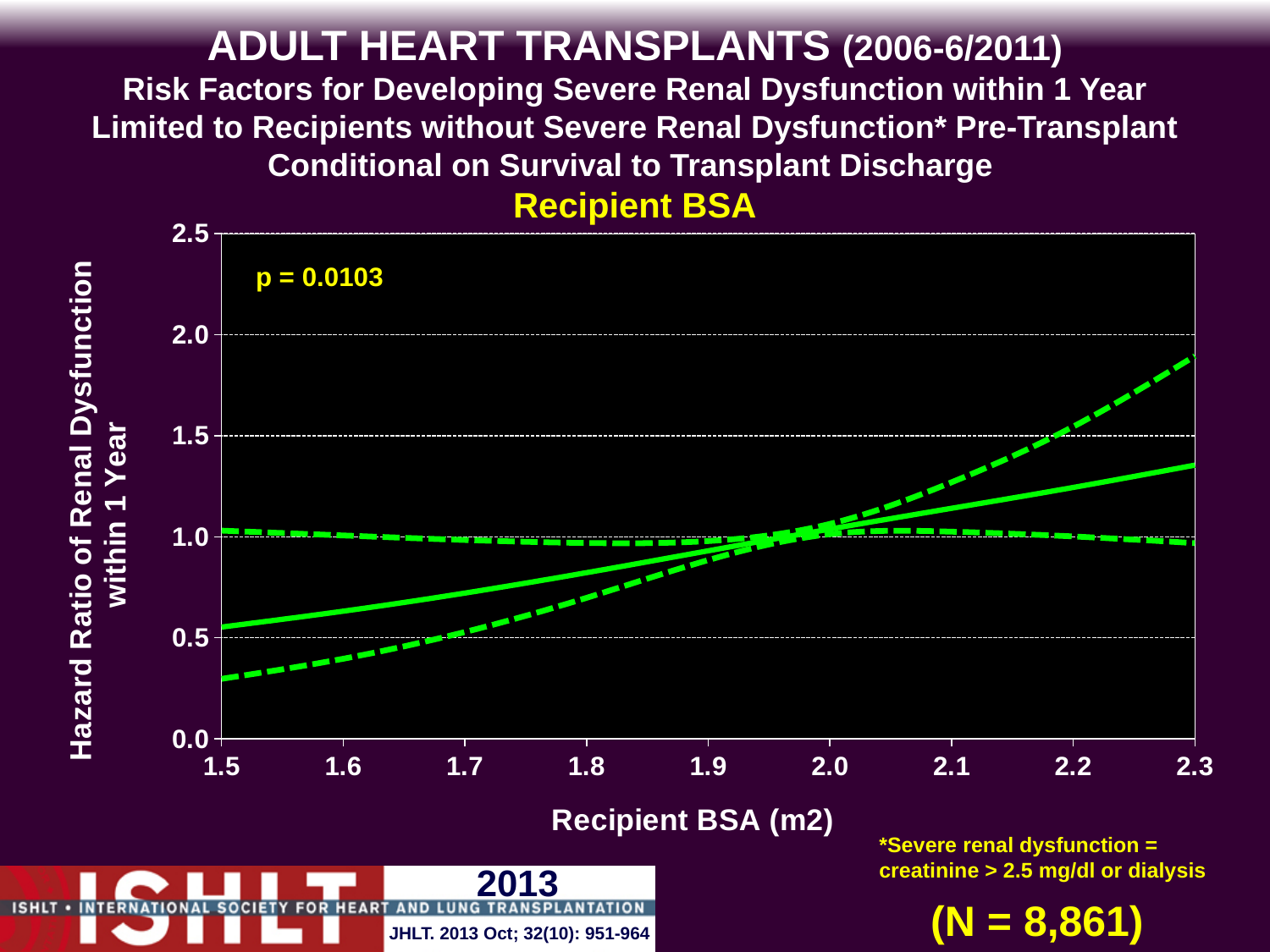
Is the hazard ratio on the solid line at a Recipient BSA of 2.3 greater or less than 1.0? greater Does the solid hazard ratio line rise or fall as Recipient BSA increases from 1.5 to 2.3? rises Is the solid line's hazard ratio larger at a Recipient BSA of 1.5 or at 2.3? 2.3 What p-value is shown on the chart? p = 0.0103 Is the upper dashed line at a Recipient BSA of 2.3 greater or less than 1.5? greater How many lines are plotted on the chart? 3 What is the highest value labelled on the y axis? 2.5 Is the hazard ratio on the solid line at a Recipient BSA of 1.5 greater or less than 1.0? less What kind of chart is shown on the slide? line chart How many tick labels are shown on the x axis? 9 What is the N shown on the slide? N = 8,861